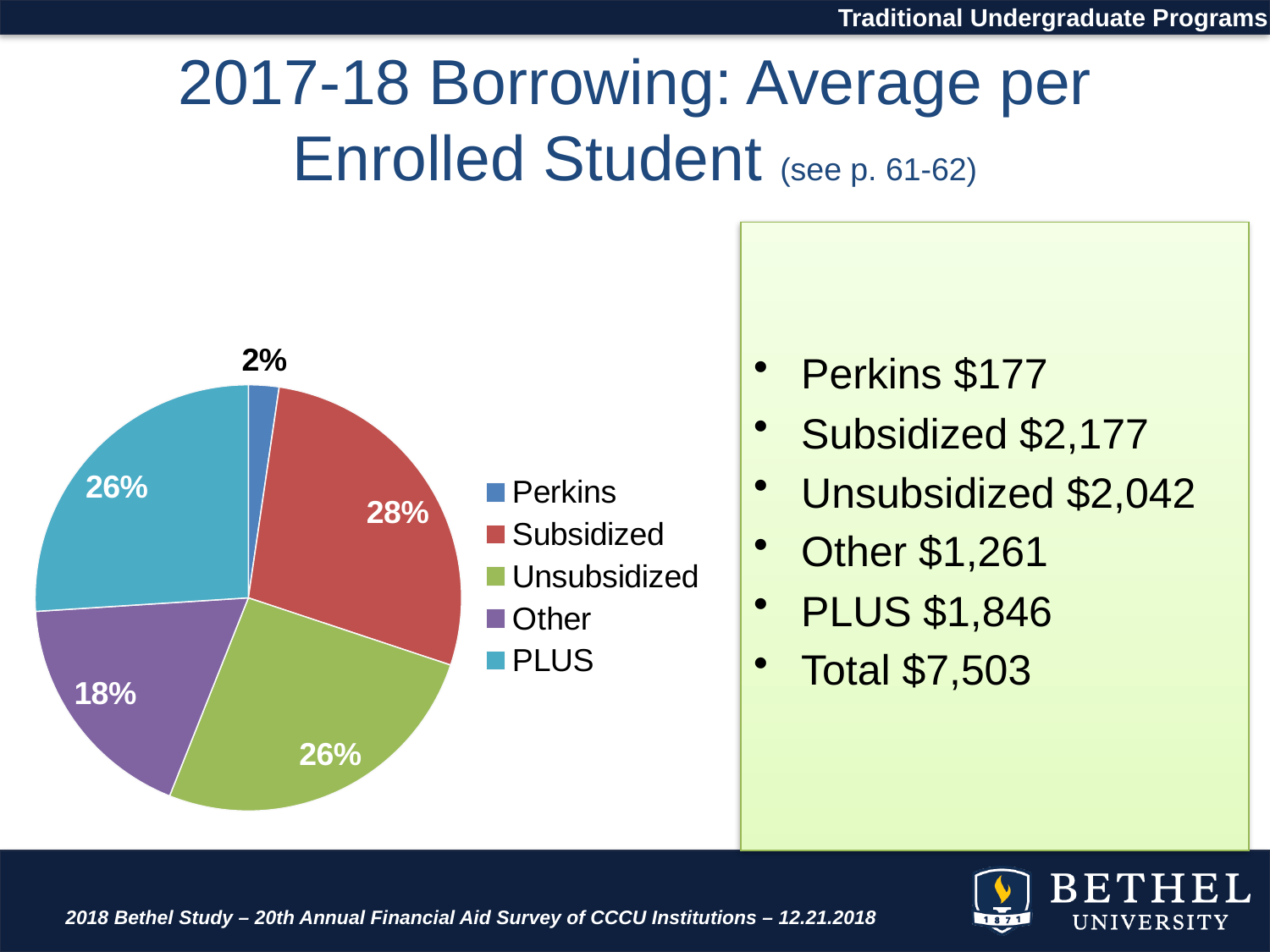
How many slices does the pie chart have? 5 What percentage is shown for the PLUS slice? 26% What share of the pie does Perkins represent? 2% Which category is shown in red in the pie chart legend? Subsidized What kind of chart is shown on the slide? pie chart What share of the pie does Subsidized represent? 28% What percentage is shown for the Unsubsidized slice? 26% What share of the pie does Other represent? 18% What is the difference in percentage points between the Subsidized slice and the Other slice? 10% Which category has the smallest slice of the pie? Perkins Which category has the largest slice of the pie? Subsidized Which slice is larger, Subsidized or Other? Subsidized